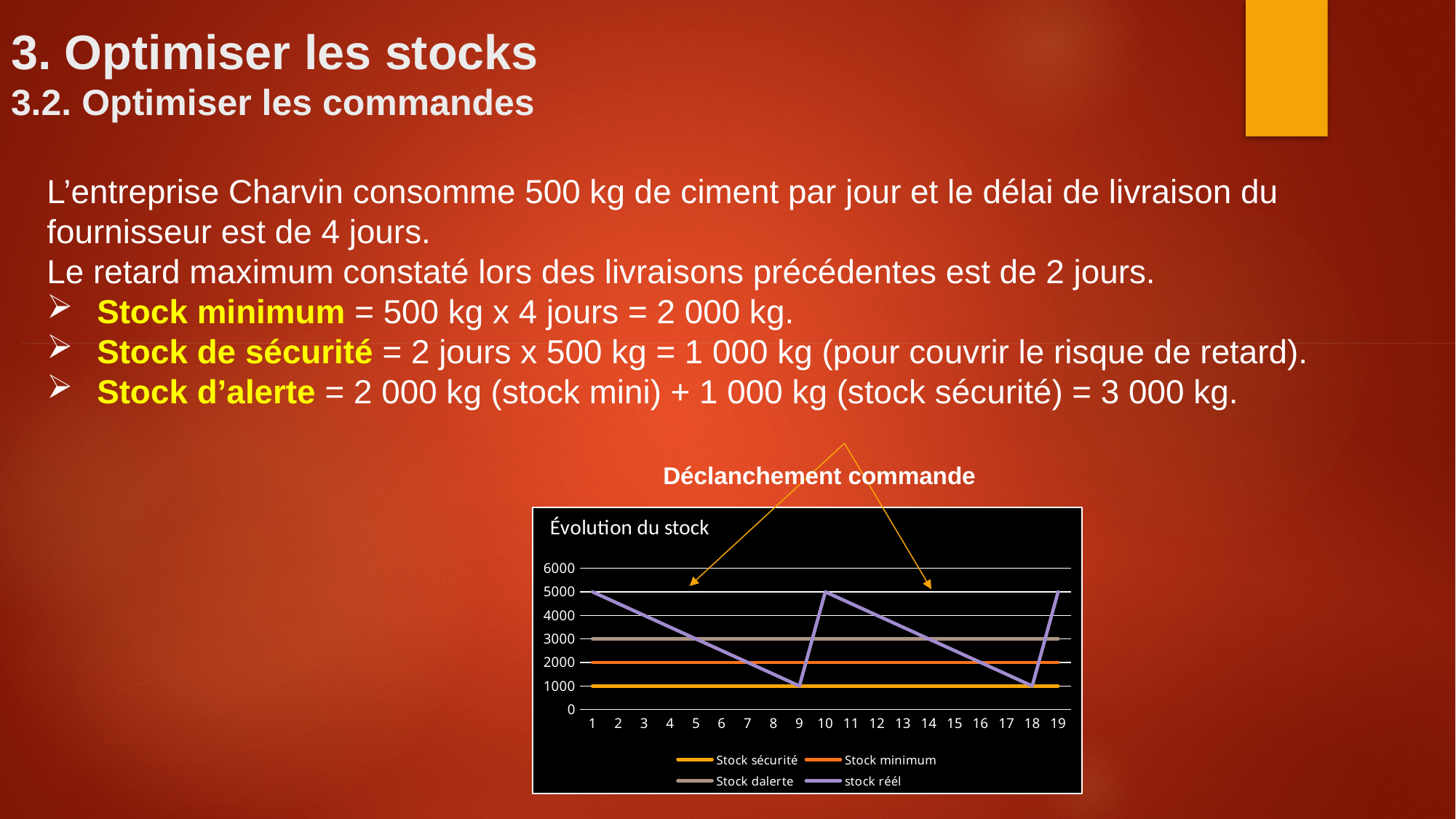
What is the difference between the Stock dalerte line and the Stock sécurité line? 2000 What is the value of the Stock sécurité line? 1000 What is the value of the Stock minimum line? 2000 How many points are there along the x axis of the chart? 19 What is the value of stock réél at point 9? 1000 What is the title of the chart? Évolution du stock How many series does the chart legend list? 4 Does the stock réél line rise or fall from point 1 to point 9? fall What is the value of the Stock dalerte line? 3000 What kind of chart is shown on the slide? line chart Which of the three flat lines is the highest: Stock sécurité, Stock minimum or Stock dalerte? Stock dalerte What is the value of stock réél at point 1? 5000